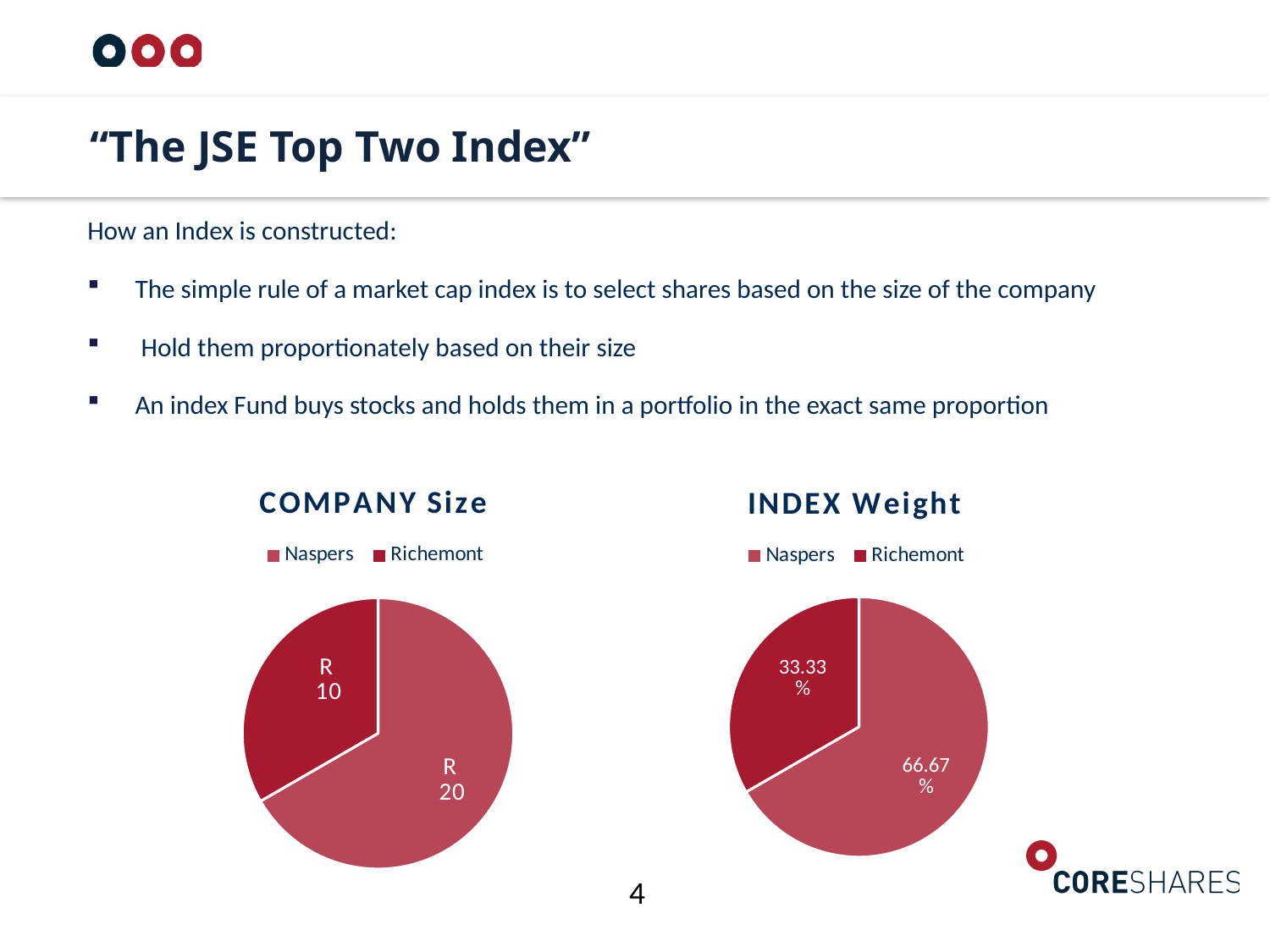
What kind of chart is the COMPANY Size chart? pie chart In the INDEX Weight chart, which company has the smaller slice? Richemont In the COMPANY Size chart, what is the value for Naspers? R 20 In the INDEX Weight chart, what is the weight for Richemont? 33.33% How many slices does the INDEX Weight pie chart have? 2 In the COMPANY Size chart, which company has the larger slice? Naspers How many entries does the legend of the COMPANY Size chart list? 2 In the COMPANY Size chart, what is the value for Richemont? R 10 What is the title of the pie chart on the right of the slide? INDEX Weight In the INDEX Weight chart, what is the weight for Naspers? 66.67% In the COMPANY Size chart, what is the difference between the Naspers and Richemont values? R 10 In the INDEX Weight chart, is the Naspers slice larger or smaller than the Richemont slice? larger